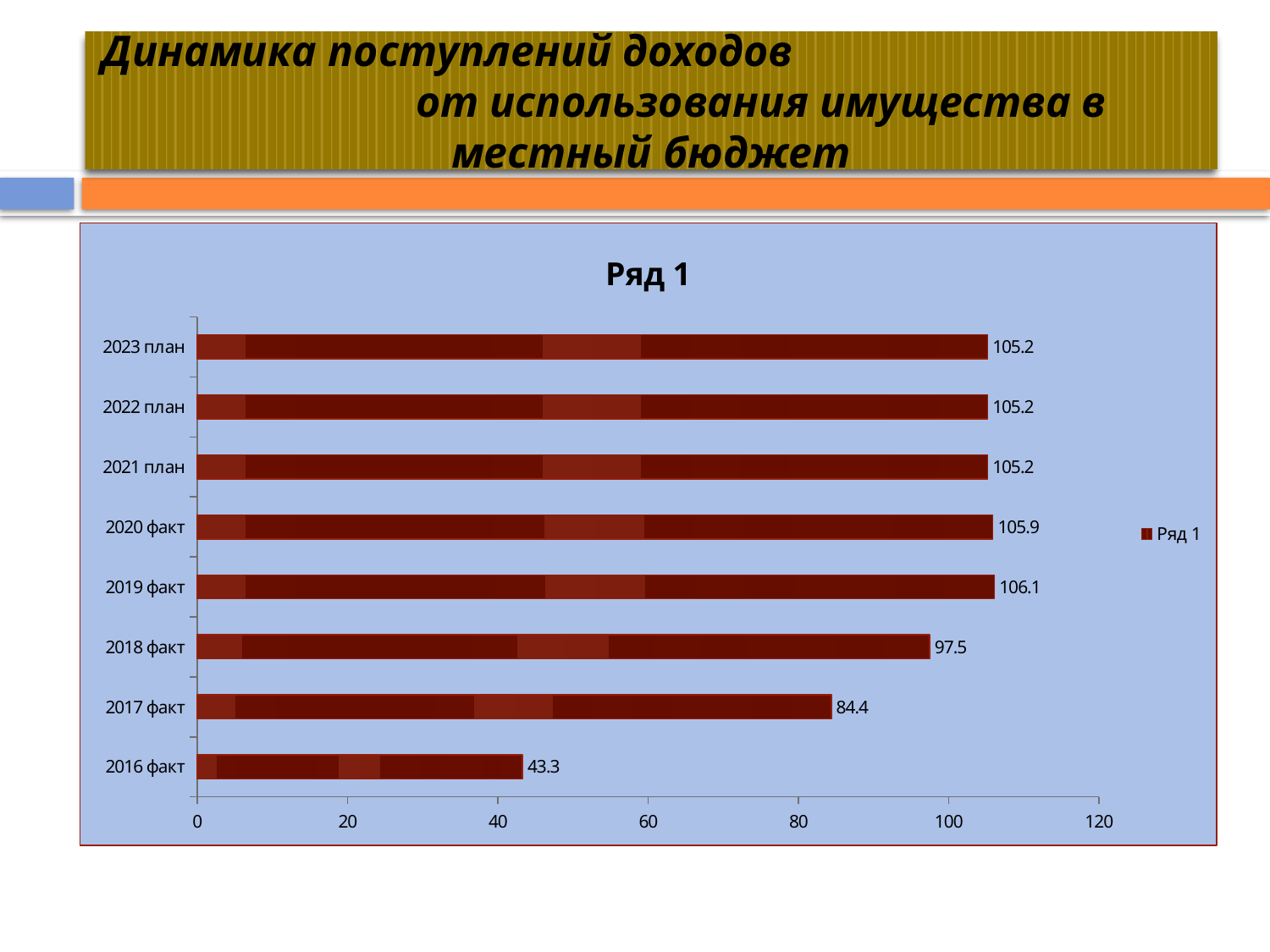
What is the difference between the values for 2017 факт and 2016 факт? 41.1 What is the value for 2016 факт? 43.3 Which category has the highest value? 2019 факт What kind of chart is shown on the slide? bar chart What is the title of the chart? Ряд 1 How many categories are shown in the chart? 8 What is the value for 2022 план? 105.2 What is the value for 2020 факт? 105.9 What is the value for 2018 факт? 97.5 Which is larger, the value for 2018 факт or the value for 2017 факт? 2018 факт Which category has the lowest value? 2016 факт Is the value for 2021 план greater or less than 100? greater